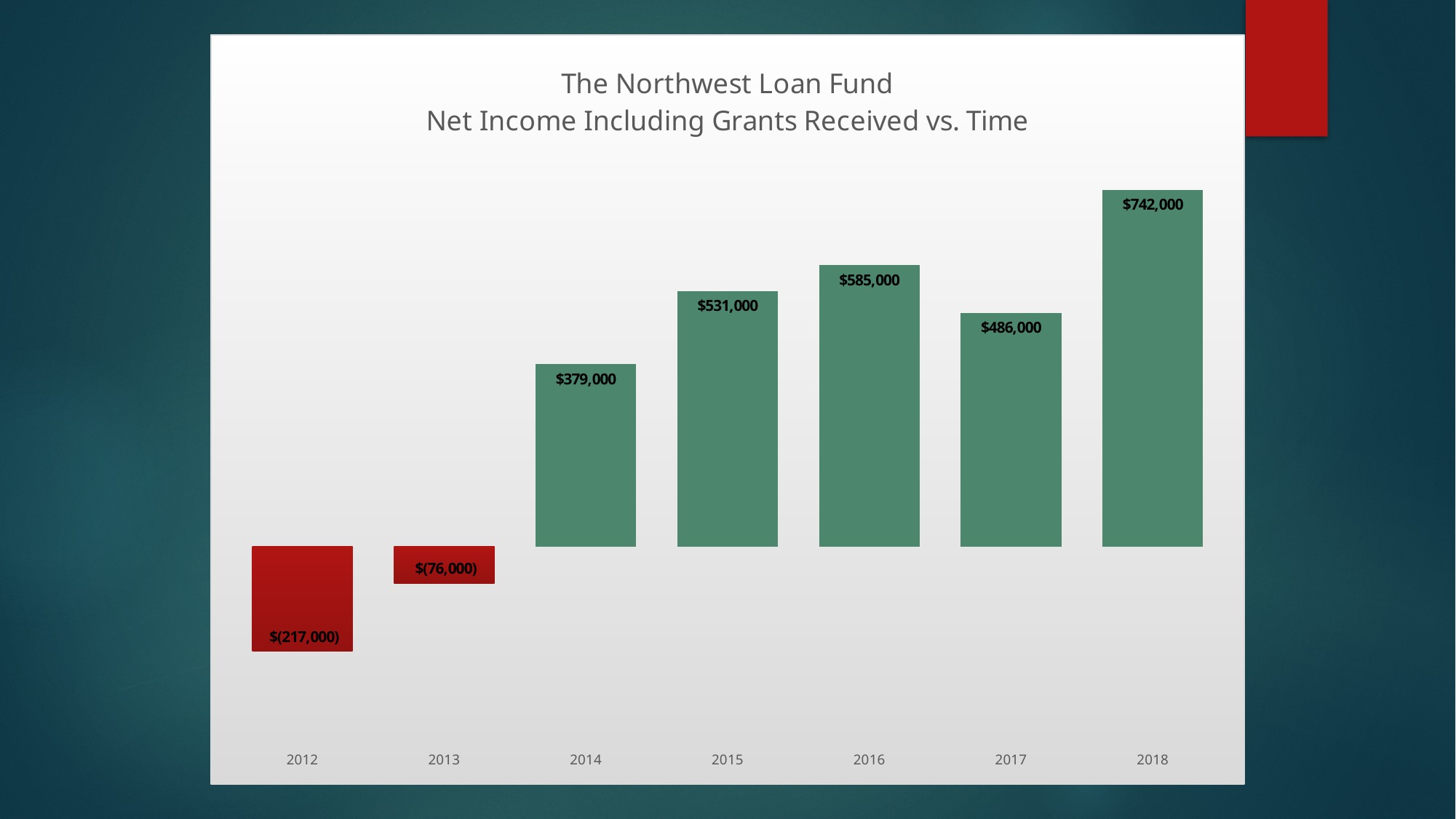
How many years are shown on the x axis? 7 What is the net income value shown for 2014? $379,000 What kind of chart is shown on the slide? Bar chart Which year has the larger value, 2015 or 2017? 2015 What is the net income value shown for 2012? $(217,000) How many years show a negative net income? 2 What is the difference between the 2018 and 2017 values? $256,000 What is the difference between the 2016 and 2015 values? $54,000 What is the net income value shown for 2017? $486,000 What colour are the bars for the years with negative values? Red Which year has the lowest net income? 2012 Which year has the highest net income? 2018